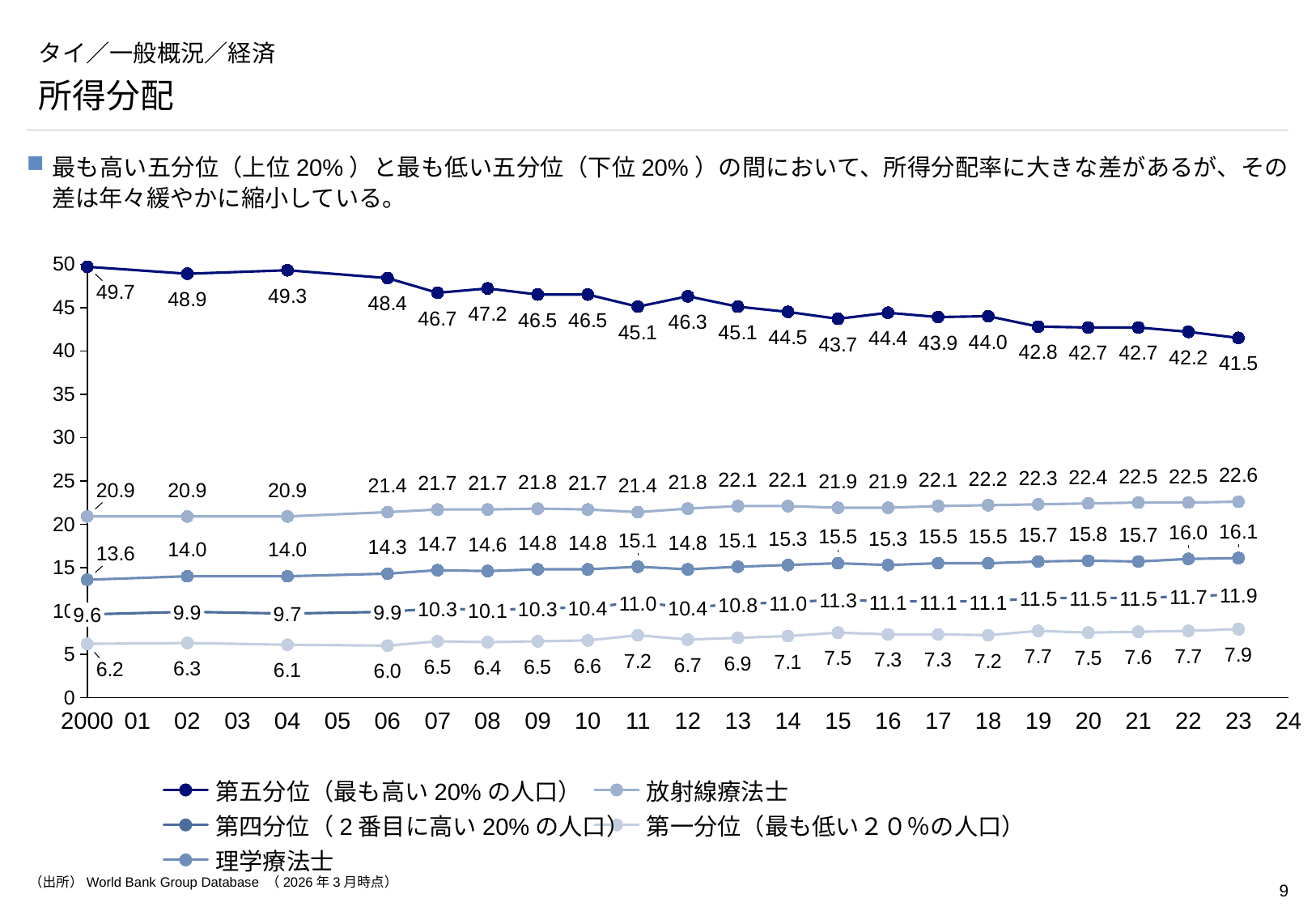
What is the difference between 第五分位（最も高い20%の人口） and 第一分位（最も低い２０％の人口） in 2023? 33.6 What kind of chart is shown on the slide? line chart What is the value for 第五分位（最も高い20%の人口） in 2000? 49.7 What is the value for 第一分位（最も低い２０％の人口） in 2023? 7.9 In which year is the value for 第五分位（最も高い20%の人口） highest? 2000 What is the value for 第四分位（2番目に高い20%の人口） in 2010? 14.8 In which year is the value for 第一分位（最も低い２０％の人口） lowest? 2006 Which is larger for 第五分位（最も高い20%の人口）: the value in 2012 or in 2013? 2012 By how much did the value for 第五分位（最も高い20%の人口） fall from 2000 to 2023? 8.2 What is the value for 第五分位（最も高い20%の人口） in 2023? 41.5 How many series does the legend list? 5 Does the value for 第五分位（最も高い20%の人口） generally rise or fall from 2000 to 2023? fall